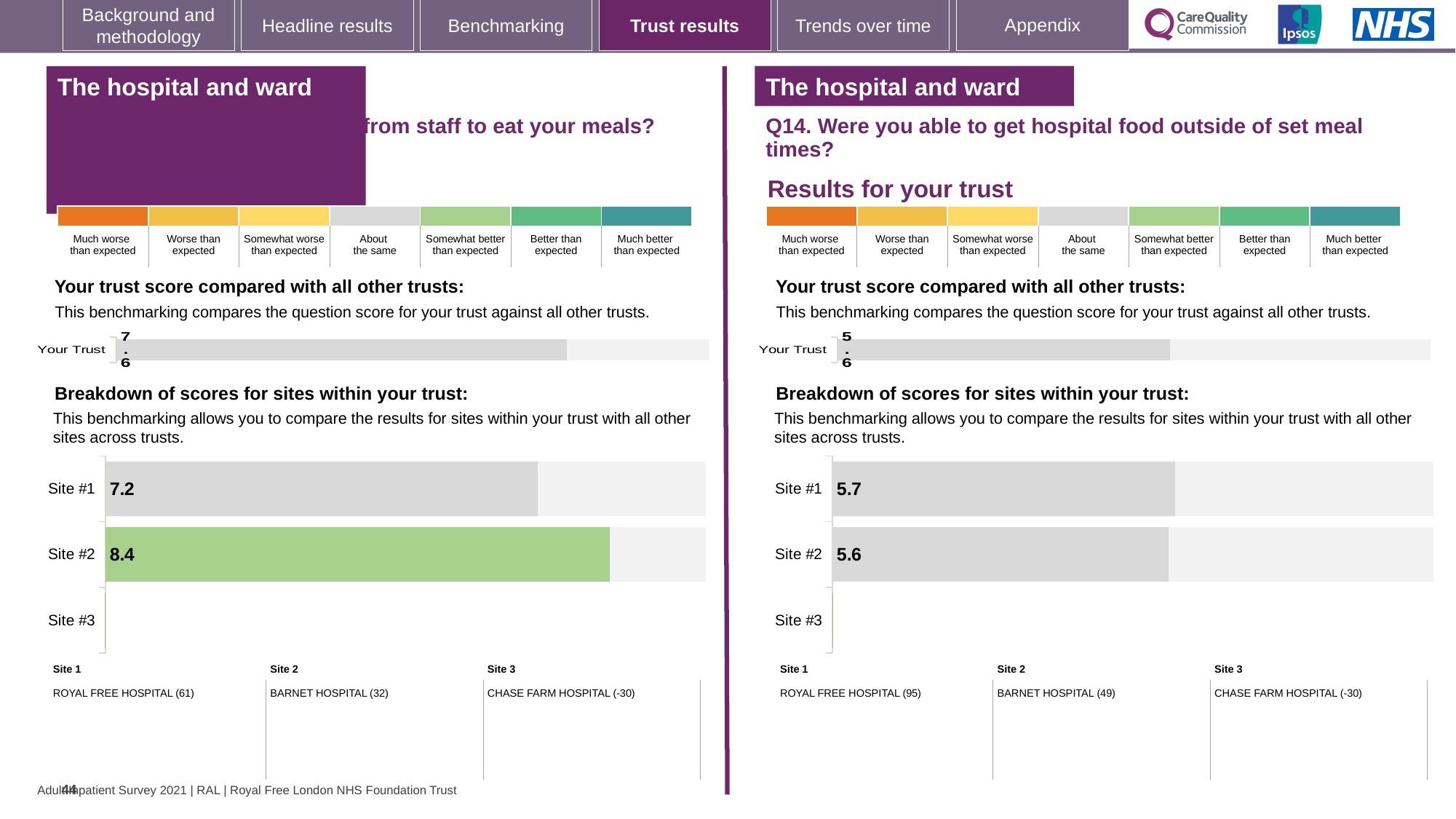
On the right-hand chart (Q14), what is the score for Site #2? 5.6 What kind of chart is used for the breakdown of scores for sites on the right-hand side? Bar chart On the right-hand chart (Q14, hospital food outside of set meal times), what is the score for Site #1? 5.7 On the left-hand chart, what is the difference between the Site #2 score and the Site #1 score? 1.2 On the left-hand chart, which site's bar is coloured green? Site #2 On the right-hand chart (Q14), what is the difference between the Site #1 score and the Site #2 score? 0.1 On the left-hand chart, what is the score for Site #2? 8.4 On the left-hand chart (question ending 'from staff to eat your meals?'), what is the score for Site #1? 7.2 On the left-hand chart, what is the 'Your Trust' score? 7.6 On the right-hand chart (Q14), what is the 'Your Trust' score? 5.6 On the left-hand chart, which site has the higher score, Site #1 or Site #2? Site #2 How many site categories are listed on the right-hand chart's site breakdown? 3